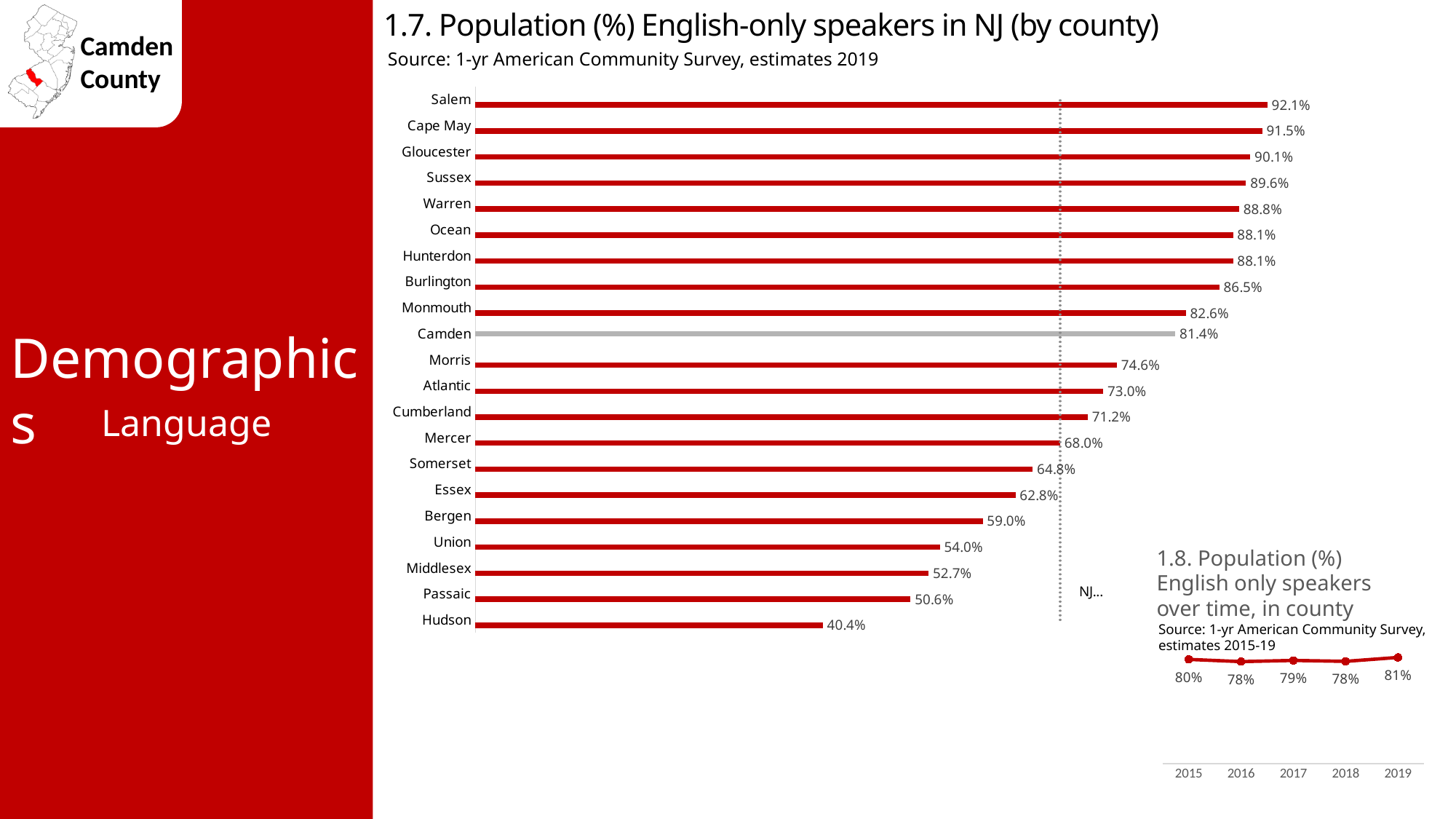
What kind of chart is '1.8. Population (%) English only speakers over time, in county'? Line chart In the chart '1.7. Population (%) English-only speakers in NJ (by county)', what is the value for Hudson? 40.4% In the chart '1.8. Population (%) English only speakers over time, in county', how many years are plotted? 5 In the chart '1.8. Population (%) English only speakers over time, in county', what is the value for 2019? 81% In the chart '1.7. Population (%) English-only speakers in NJ (by county)', what is the difference between Salem and Hudson? 51.7% In the chart '1.7. Population (%) English-only speakers in NJ (by county)', how many counties are shown? 21 In the chart '1.7. Population (%) English-only speakers in NJ (by county)', which is larger, the value for Morris or the value for Atlantic? Morris In the chart '1.7. Population (%) English-only speakers in NJ (by county)', what is the value for Bergen? 59.0% In the chart '1.7. Population (%) English-only speakers in NJ (by county)', which county has the lowest value? Hudson In the chart '1.7. Population (%) English-only speakers in NJ (by county)', what is the value for Camden? 81.4% In the chart '1.7. Population (%) English-only speakers in NJ (by county)', which county has the highest value? Salem What kind of chart is '1.7. Population (%) English-only speakers in NJ (by county)'? Bar chart